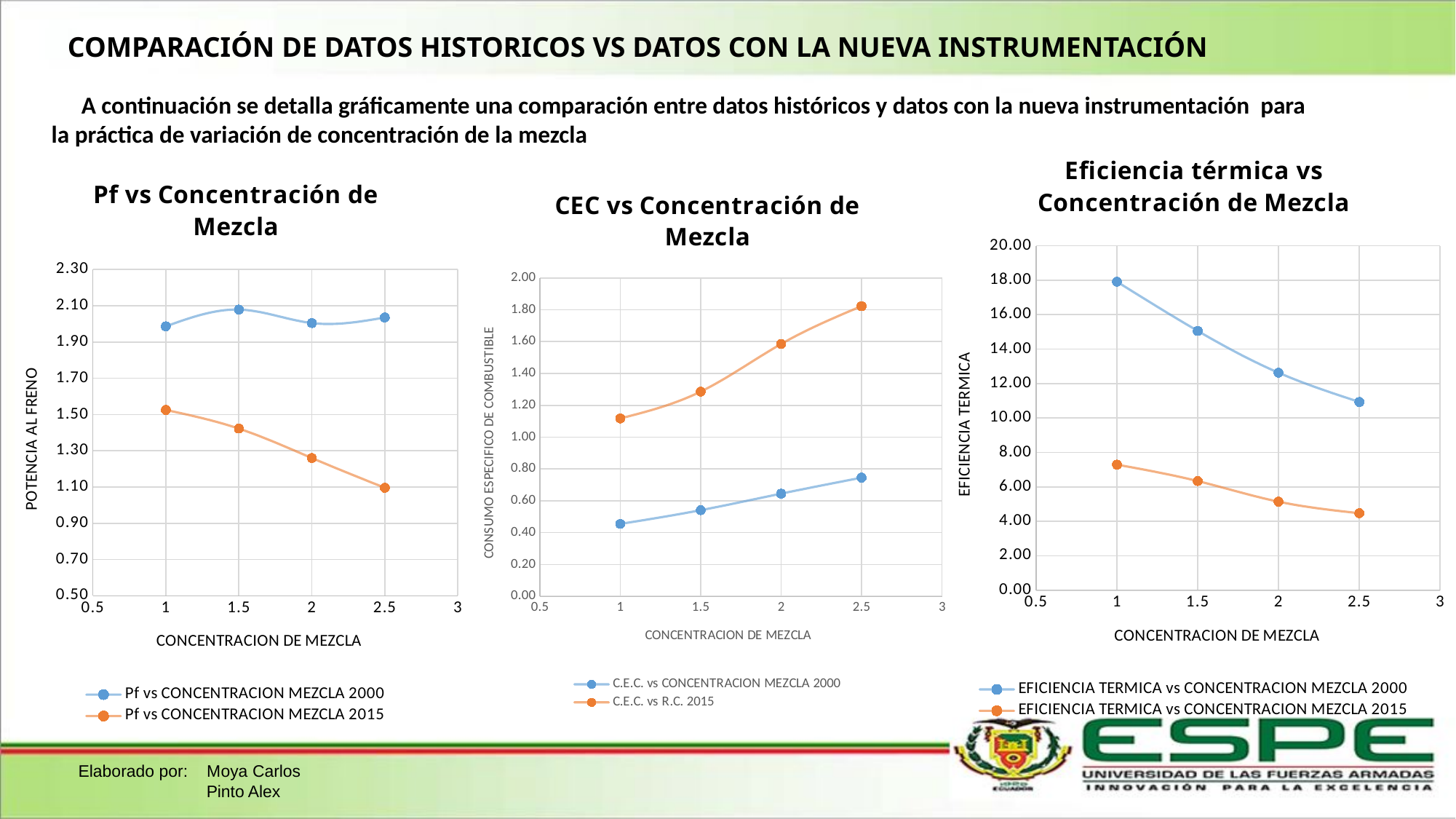
In the 'Pf vs Concentración de Mezcla' chart, how many data points does the 'Pf vs CONCENTRACION MEZCLA 2015' series have? 4 In the 'Eficiencia térmica vs Concentración de Mezcla' chart, is the value of the 2015 series at concentration 2.5 greater or less than 6.00? less In the 'CEC vs Concentración de Mezcla' chart, does the 'C.E.C. vs R.C. 2015' series rise or fall as concentration increases? rise In the 'Pf vs Concentración de Mezcla' chart, is the value of the 2000 series at concentration 1.5 greater or less than 1.90? greater In the 'Pf vs Concentración de Mezcla' chart, how many series does the legend list? 2 What kind of chart is the 'Pf vs Concentración de Mezcla' chart on the left? line chart What is the y-axis label of the 'CEC vs Concentración de Mezcla' chart? CONSUMO ESPECIFICO DE COMBUSTIBLE In the 'Eficiencia térmica vs Concentración de Mezcla' chart, at which concentration is the 2000 series highest? 1 In the 'Pf vs Concentración de Mezcla' chart, does the 'Pf vs CONCENTRACION MEZCLA 2015' series rise or fall as concentration increases? fall In the 'Pf vs Concentración de Mezcla' chart, at concentration 2, which series has the larger value: 2000 or 2015? 2000 In the 'CEC vs Concentración de Mezcla' chart, is the value of the 'C.E.C. vs R.C. 2015' series at concentration 2.5 greater or less than 1.60? greater